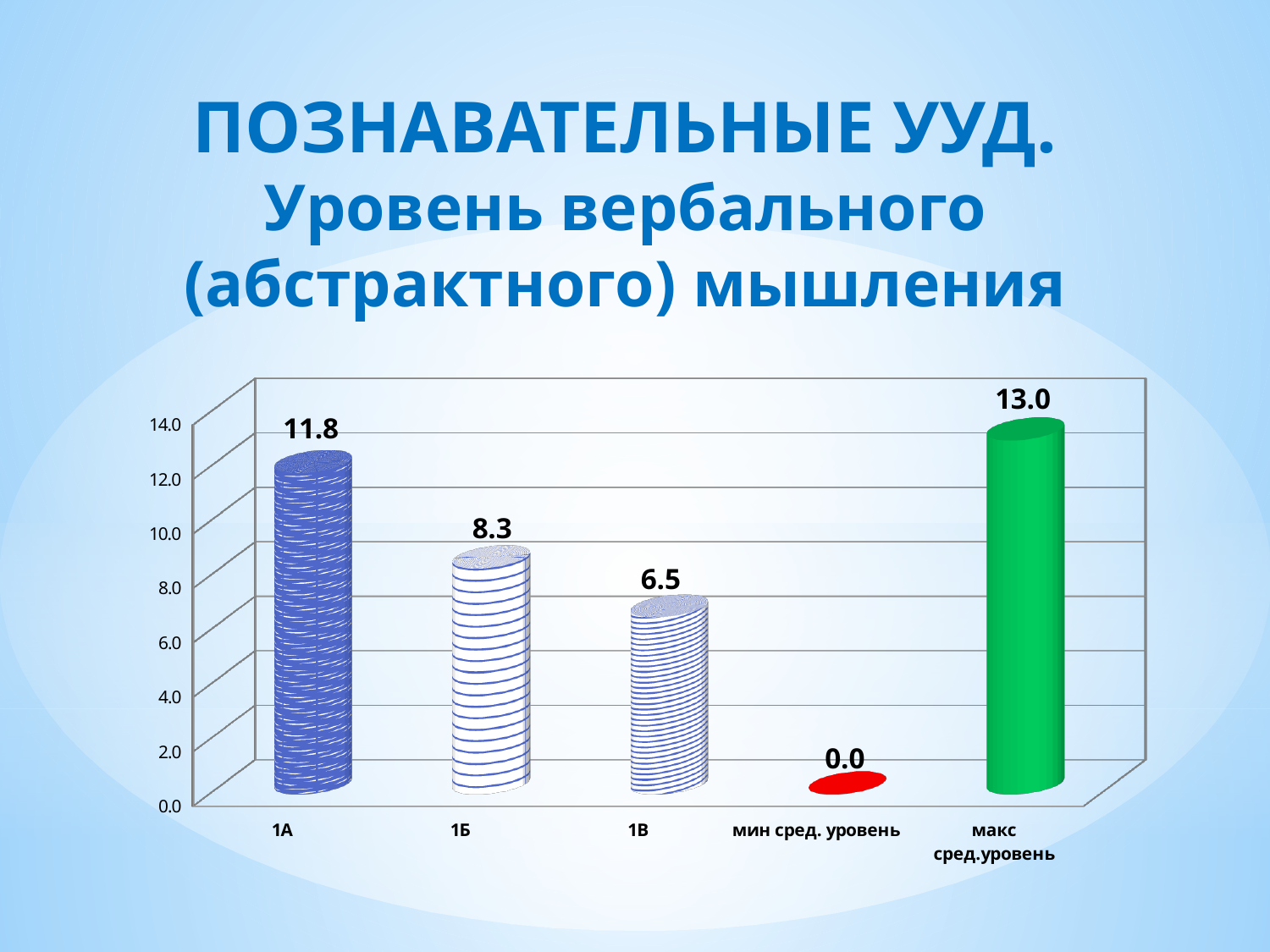
What is the difference between the values for 1А and 1Б? 3.5 What is the value for 1А? 11.8 Which category has the highest value? макс сред.уровень What is the value for 1Б? 8.3 How many categories are shown on the x axis? 5 Which category has the lowest value? мин сред. уровень What is the value for 1В? 6.5 What is the value for мин сред. уровень? 0.0 Which is larger, the value for 1Б or the value for 1В? 1Б What kind of chart is shown on the slide? bar chart What colour is the bar for макс сред.уровень? green What is the value for макс сред.уровень? 13.0